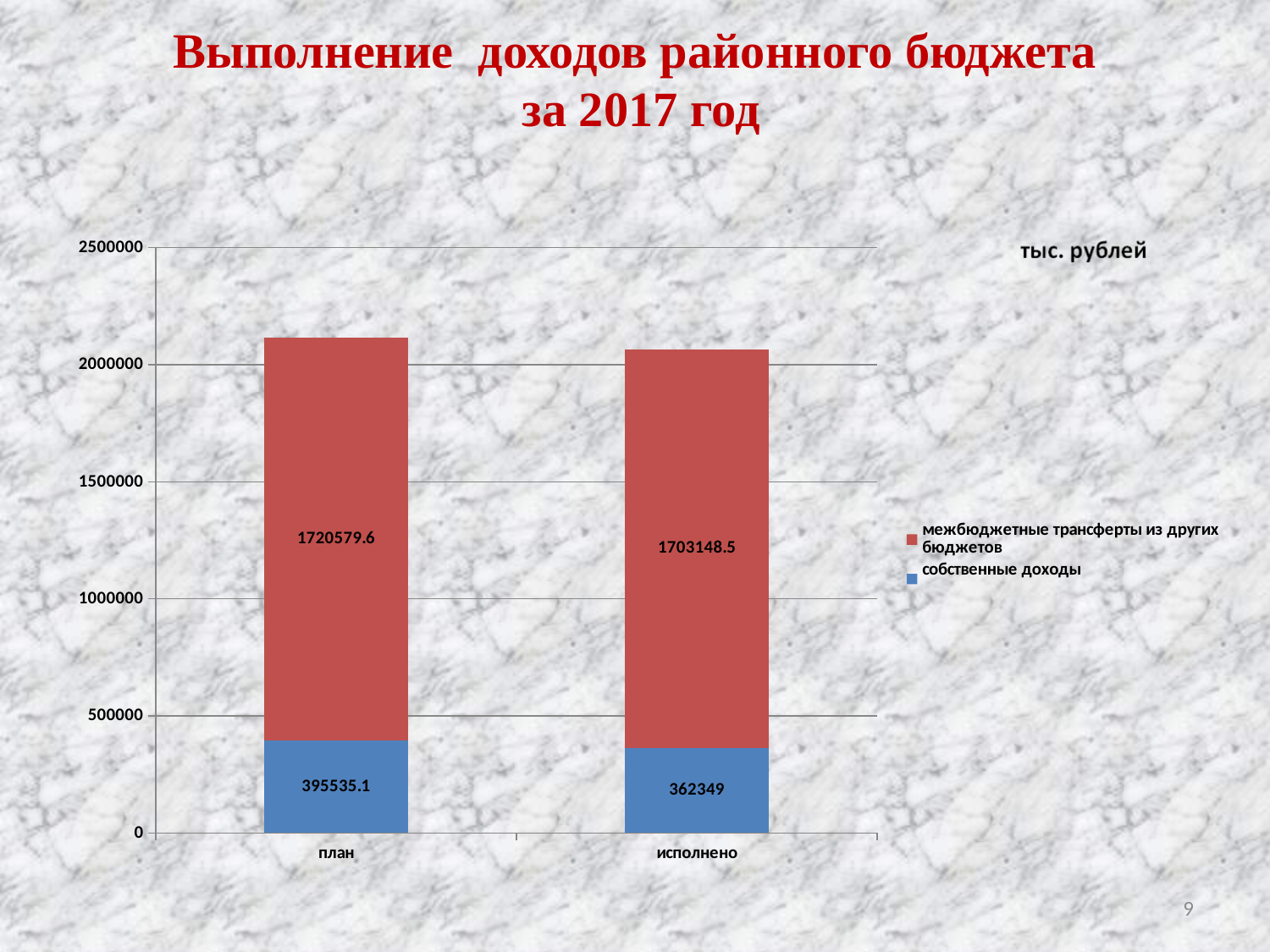
What is the value of собственные доходы for план? 395535.1 Which is larger: собственные доходы for план or for исполнено? план What is the difference between межбюджетные трансферты из других бюджетов for план and for исполнено? 17431.1 What kind of chart is shown on the slide? Stacked bar chart What is the value of собственные доходы for исполнено? 362349 What is the total of the stacked bar for план? 2116114.7 How many categories are shown on the x axis? 2 What is the total of the stacked bar for исполнено? 2065497.5 What is the value of межбюджетные трансферты из других бюджетов for исполнено? 1703148.5 What is the difference between собственные доходы for план and for исполнено? 33186.1 How many series does the legend list? 2 What is the value of межбюджетные трансферты из других бюджетов for план? 1720579.6